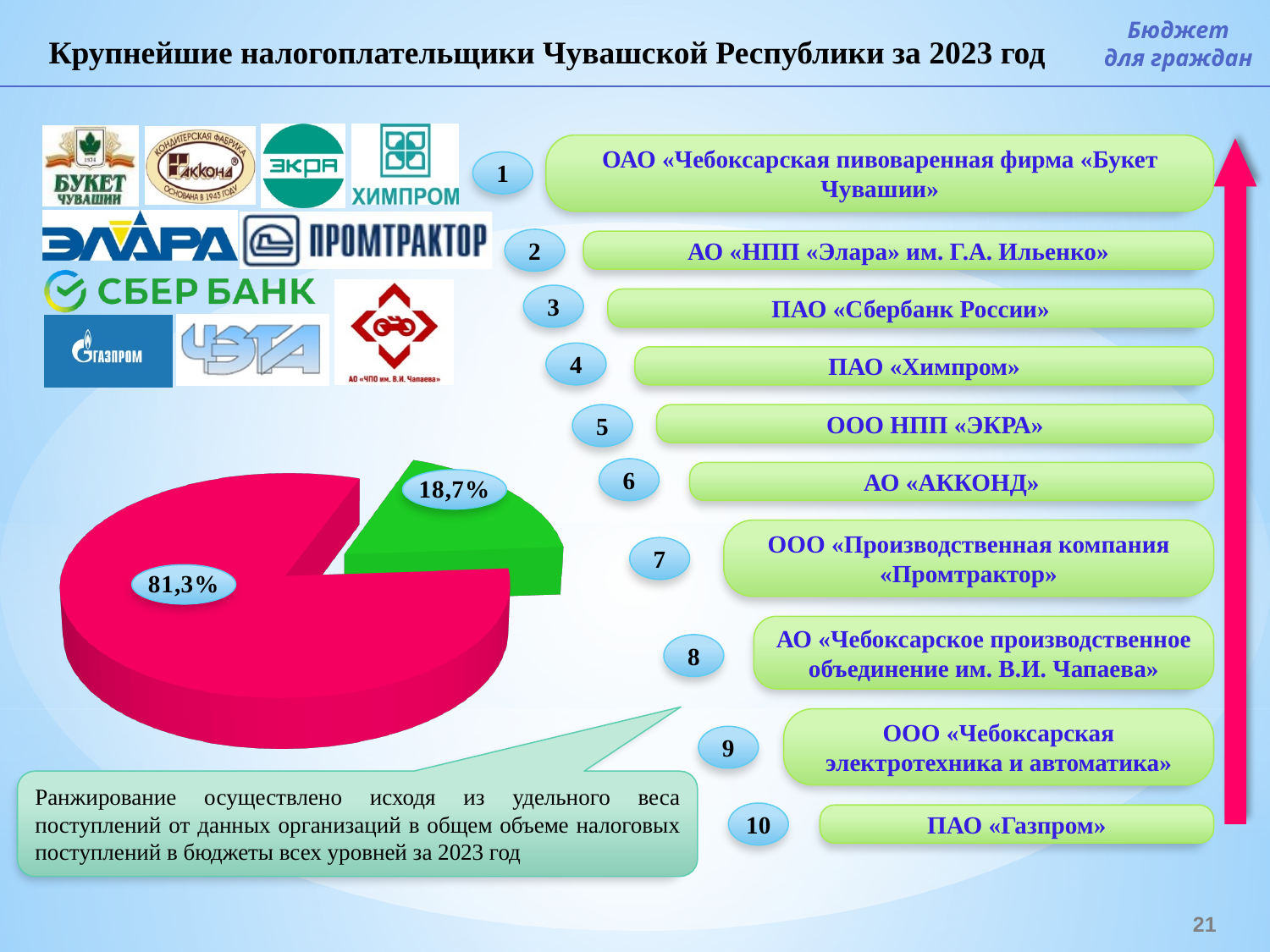
What value is labelled on the pink slice of the pie chart? 81,3% Which slice of the pie chart is pulled out (exploded) from the rest of the pie? the green slice (18,7%) Which slice of the pie chart is the largest? the pink slice (81,3%) How many slices does the pie chart have? 2 What share of the pie does the green slice represent? 18,7% What is the difference between the pink slice and the green slice of the pie chart? 62,6% Which is larger in the pie chart, the pink slice or the green slice? the pink slice What value is labelled on the green slice of the pie chart? 18,7% Which slice of the pie chart is the smallest? the green slice (18,7%) Is the value of the green slice of the pie chart greater or less than 20%? less Is the value of the pink slice of the pie chart greater or less than 80%? greater What kind of chart is shown on the slide? pie chart